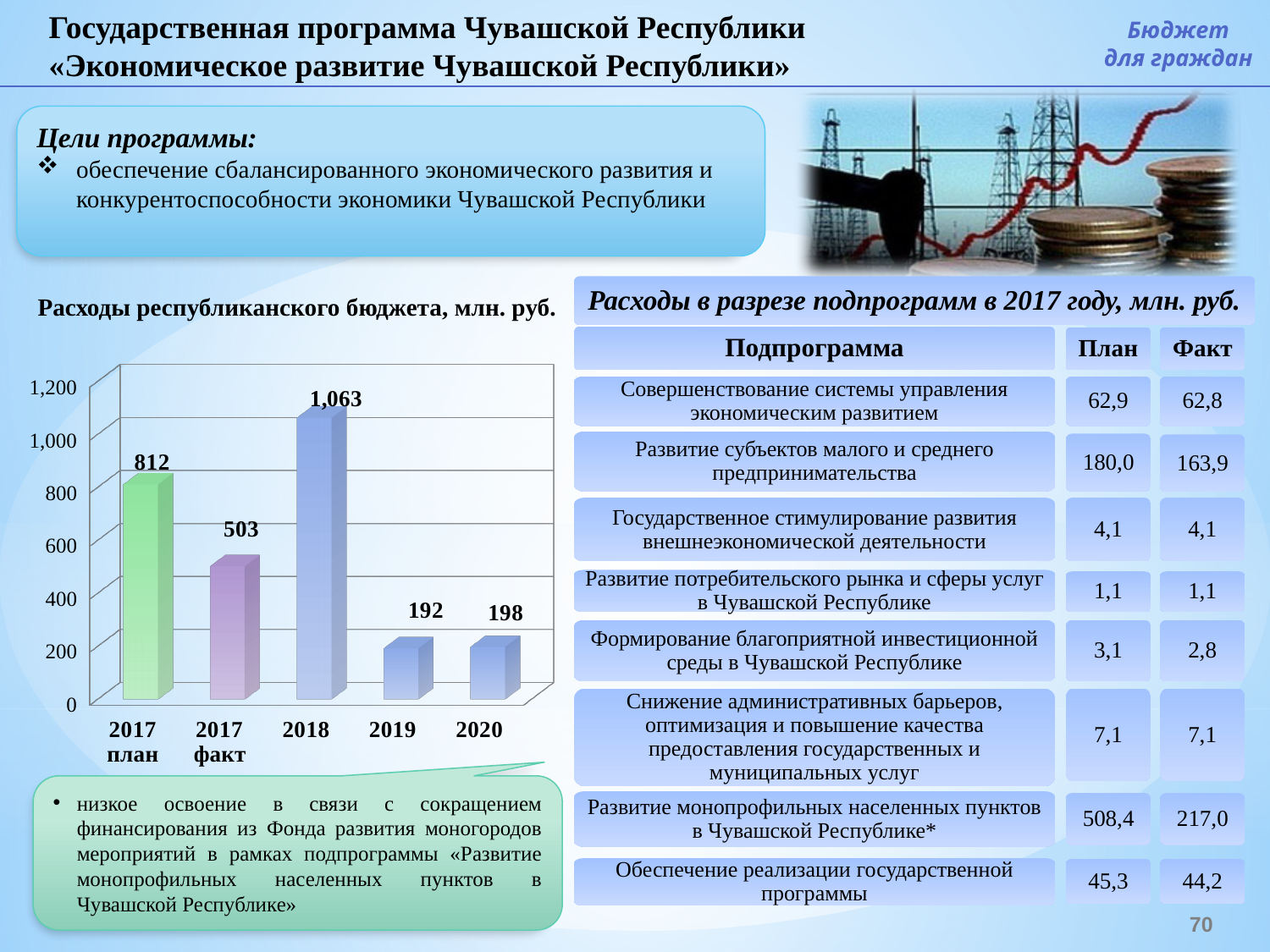
Is the value for 2017 факт greater or less than 600 in the chart 'Расходы республиканского бюджета, млн. руб.'? less What is the value for 2017 план in the chart 'Расходы республиканского бюджета, млн. руб.'? 812 How many bars are shown in the chart 'Расходы республиканского бюджета, млн. руб.'? 5 What is the value for 2020 in the chart 'Расходы республиканского бюджета, млн. руб.'? 198 Which is larger in the chart 'Расходы республиканского бюджета, млн. руб.': the value for 2017 план or the value for 2018? 2018 What is the value for 2017 факт in the chart 'Расходы республиканского бюджета, млн. руб.'? 503 What kind of chart is 'Расходы республиканского бюджета, млн. руб.'? bar chart What is the difference between the 2018 and 2019 values in the chart 'Расходы республиканского бюджета, млн. руб.'? 871 Which category has the lowest value in the chart 'Расходы республиканского бюджета, млн. руб.'? 2019 What is the value for 2018 in the chart 'Расходы республиканского бюджета, млн. руб.'? 1,063 Which category has the highest value in the chart 'Расходы республиканского бюджета, млн. руб.'? 2018 What is the difference between the 2017 план and 2017 факт values in the chart 'Расходы республиканского бюджета, млн. руб.'? 309